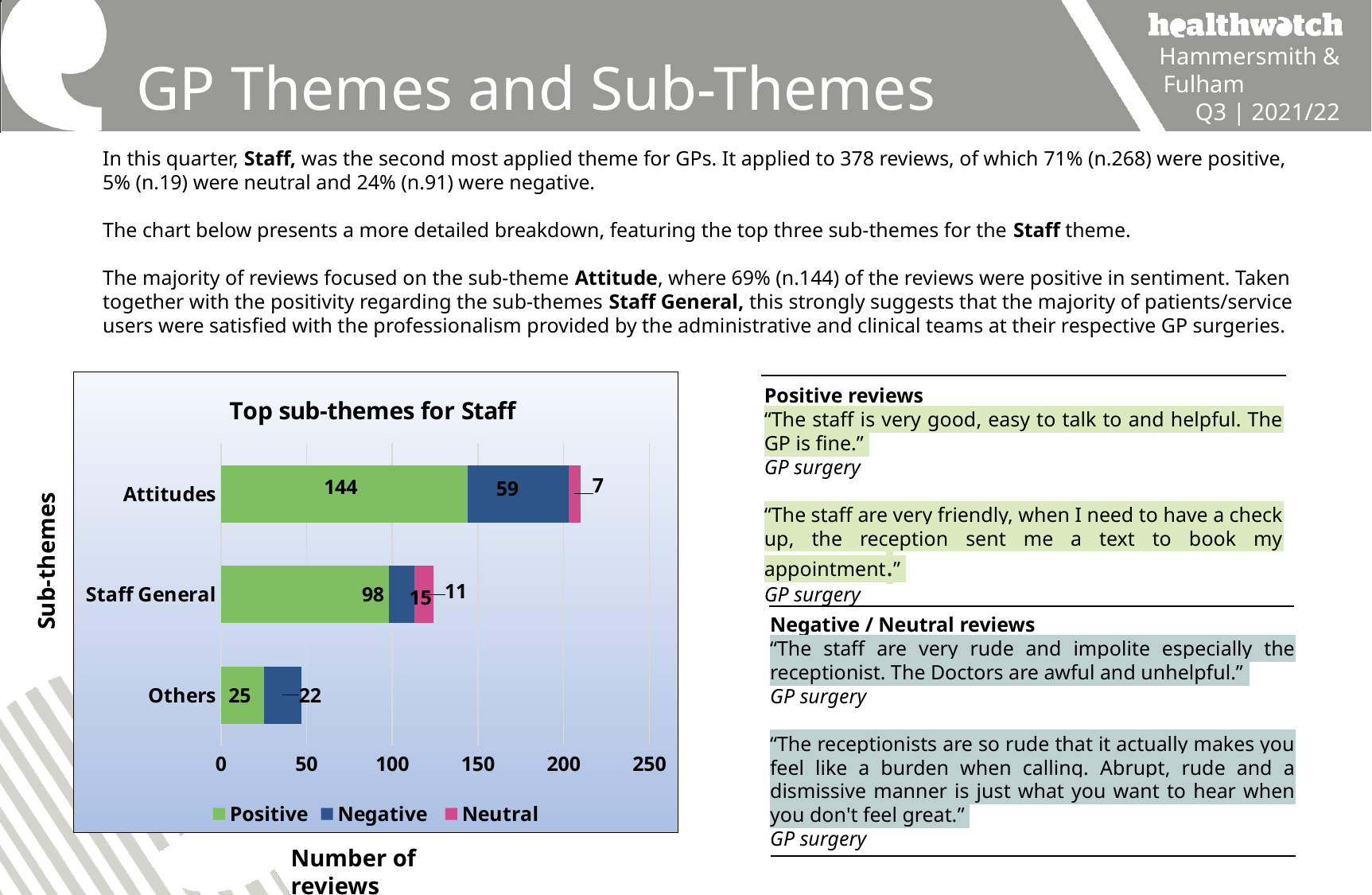
What is the Positive value for Attitudes in the 'Top sub-themes for Staff' chart? 144 How many series does the legend of 'Top sub-themes for Staff' list? 3 Is the total length of the Staff General bar in the 'Top sub-themes for Staff' chart greater or less than 150? less Which sub-theme has the highest Positive value in the 'Top sub-themes for Staff' chart? Attitudes What is the Neutral value for Attitudes in the 'Top sub-themes for Staff' chart? 7 What type of chart is 'Top sub-themes for Staff'? stacked bar chart What is the difference between the Positive values for Attitudes and Staff General in the 'Top sub-themes for Staff' chart? 46 How many sub-themes are shown in the 'Top sub-themes for Staff' chart? 3 In the 'Top sub-themes for Staff' chart, is the Negative value for Attitudes or for Others larger? Attitudes Which sub-theme has the lowest Negative value in the 'Top sub-themes for Staff' chart? Staff General What is the total number of reviews for the Attitudes bar in the 'Top sub-themes for Staff' chart? 210 What is the Negative value for Staff General in the 'Top sub-themes for Staff' chart? 15